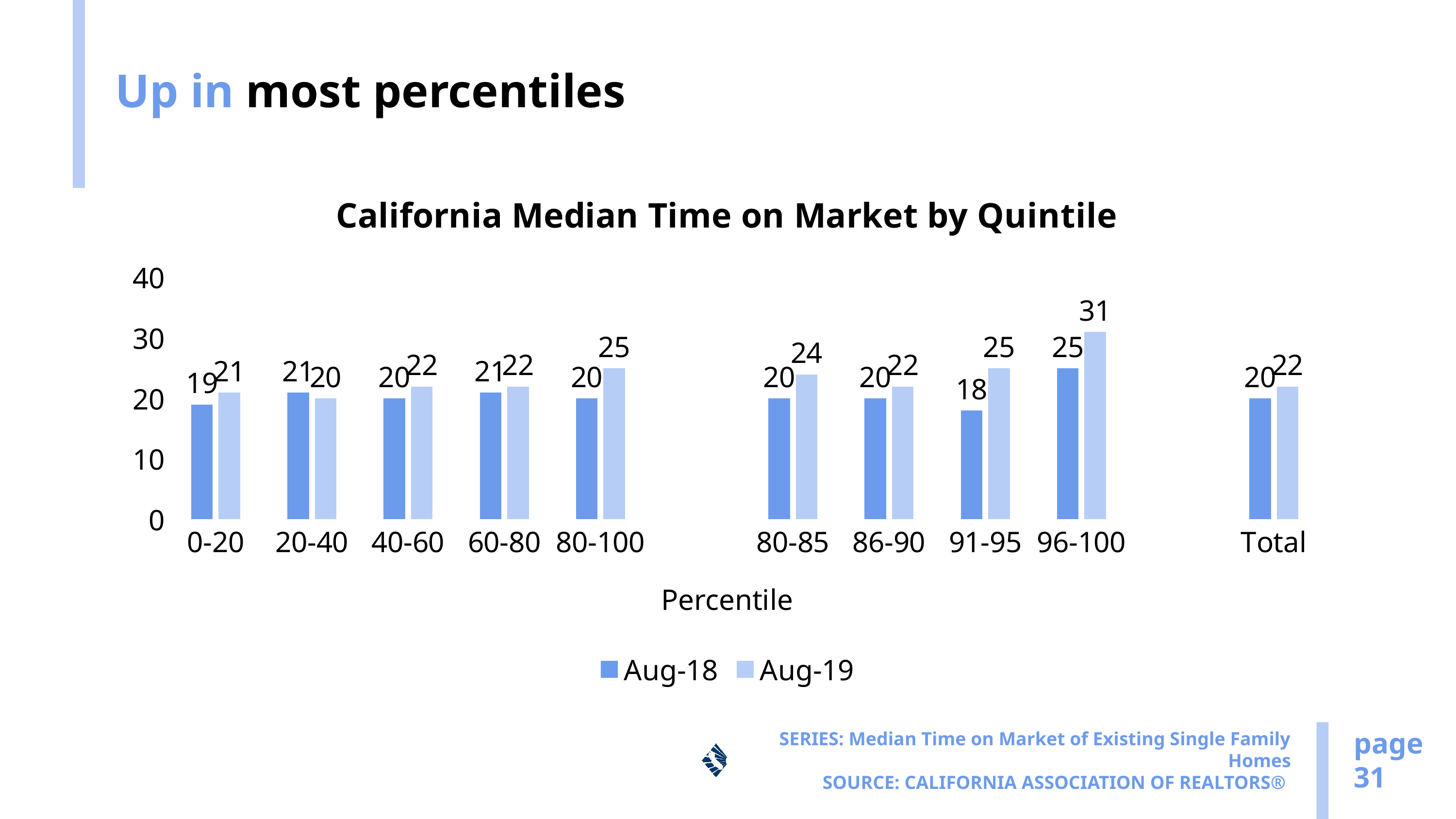
Which percentile has the highest Aug-19 value? 96-100 What is the title of the chart? California Median Time on Market by Quintile For the 20-40 percentile, which is larger, the Aug-18 value or the Aug-19 value? Aug-18 What is the difference between the Aug-19 and Aug-18 values for the 91-95 percentile? 7 What is the Aug-18 value for Total? 20 What is the Aug-18 value for the 91-95 percentile? 18 What is the Aug-19 value for the 96-100 percentile? 31 Which percentile has the lowest Aug-18 value? 91-95 What kind of chart is shown on the slide? Bar chart What is the Aug-19 value for the 80-100 percentile? 25 Is the Aug-19 value for the 96-100 percentile greater or less than 30? greater How many series does the legend list? 2